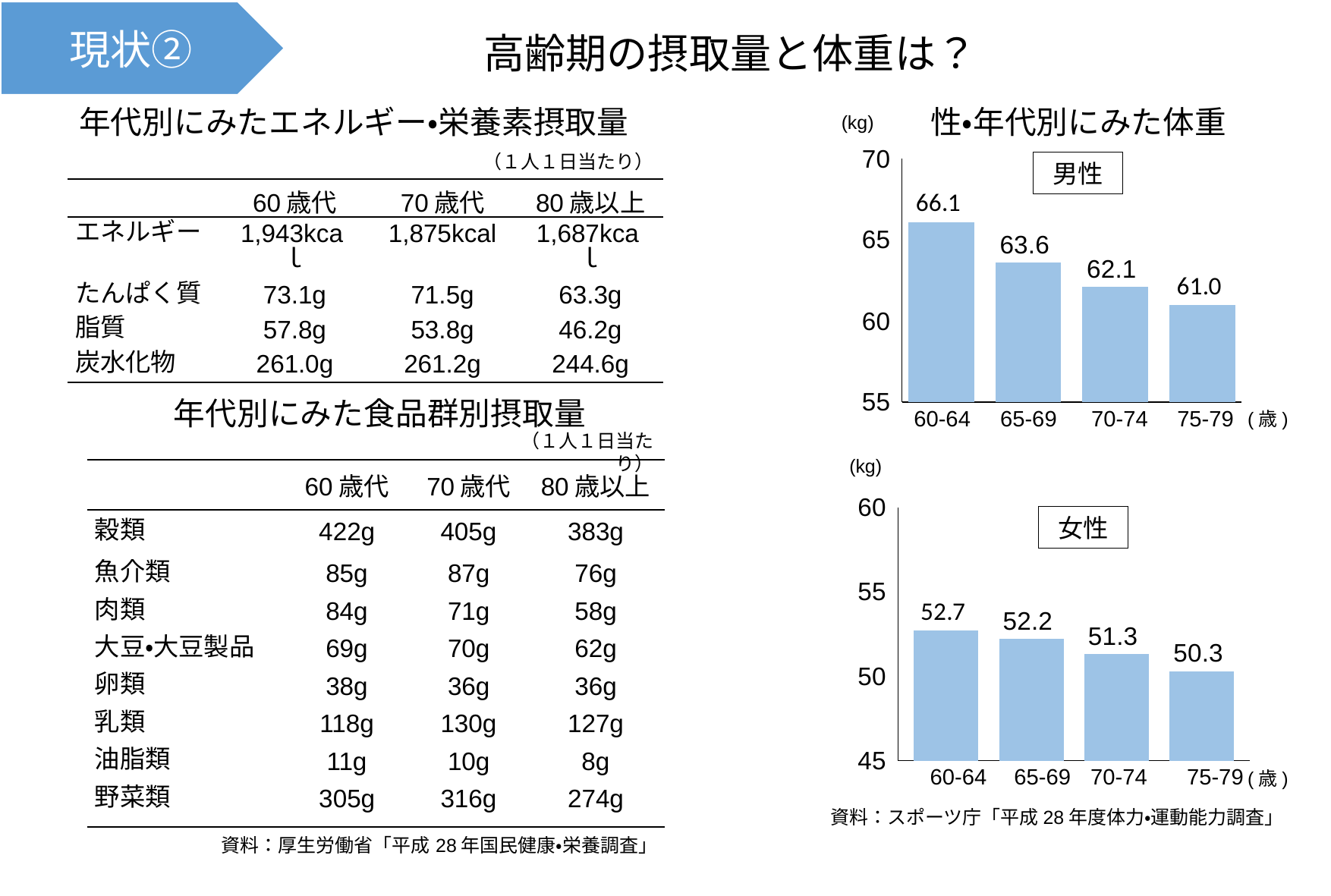
In the 男性 (male) chart, do the values rise or fall as the age group increases? fall In the 男性 (male) chart, which age group has the highest value? 60-64 In the 男性 (male) chart, which is larger, the value for 65-69 or the value for 70-74? 65-69 In the 男性 (male) chart, what is the difference between the values for 60-64 and 75-79? 5.1 What unit is shown on the y axis of the 女性 (female) chart? kg In the 女性 (female) chart, what is the difference between the values for 60-64 and 70-74? 1.4 How many age groups are shown in the 男性 (male) chart? 4 What kind of chart is the 女性 (female) chart? bar chart In the 女性 (female) chart, which age group has the lowest value? 75-79 In the 女性 (female) chart, is the value for 70-74 greater or less than 55? less In the 女性 (female) chart, what is the value for the 75-79 age group? 50.3 In the 男性 (male) chart, what is the value for the 60-64 age group? 66.1